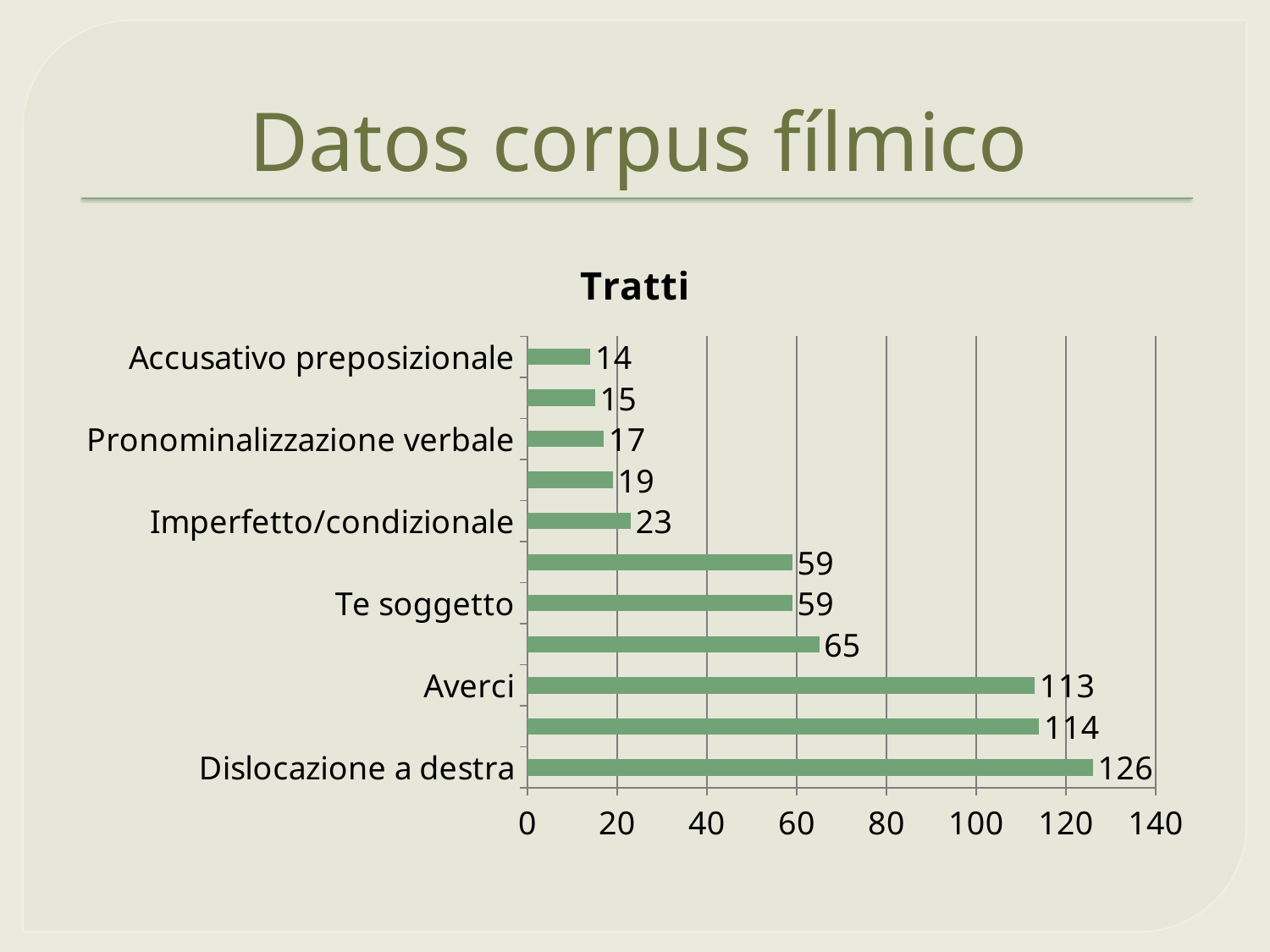
What is the value for Imperfetto/condizionale? 23 What is the value for Accusativo preposizionale? 14 What type of chart is shown on the slide? Bar chart How many bars are plotted in the chart? 11 What is the value for Dislocazione a destra? 126 Which category has the highest value? Dislocazione a destra What is the difference between the values for Dislocazione a destra and Averci? 13 Which category has the lowest value? Accusativo preposizionale What is the value for Te soggetto? 59 Which is larger, the value for Averci or the value for Te soggetto? Averci What is the value for Averci? 113 What is the value for Pronominalizzazione verbale? 17